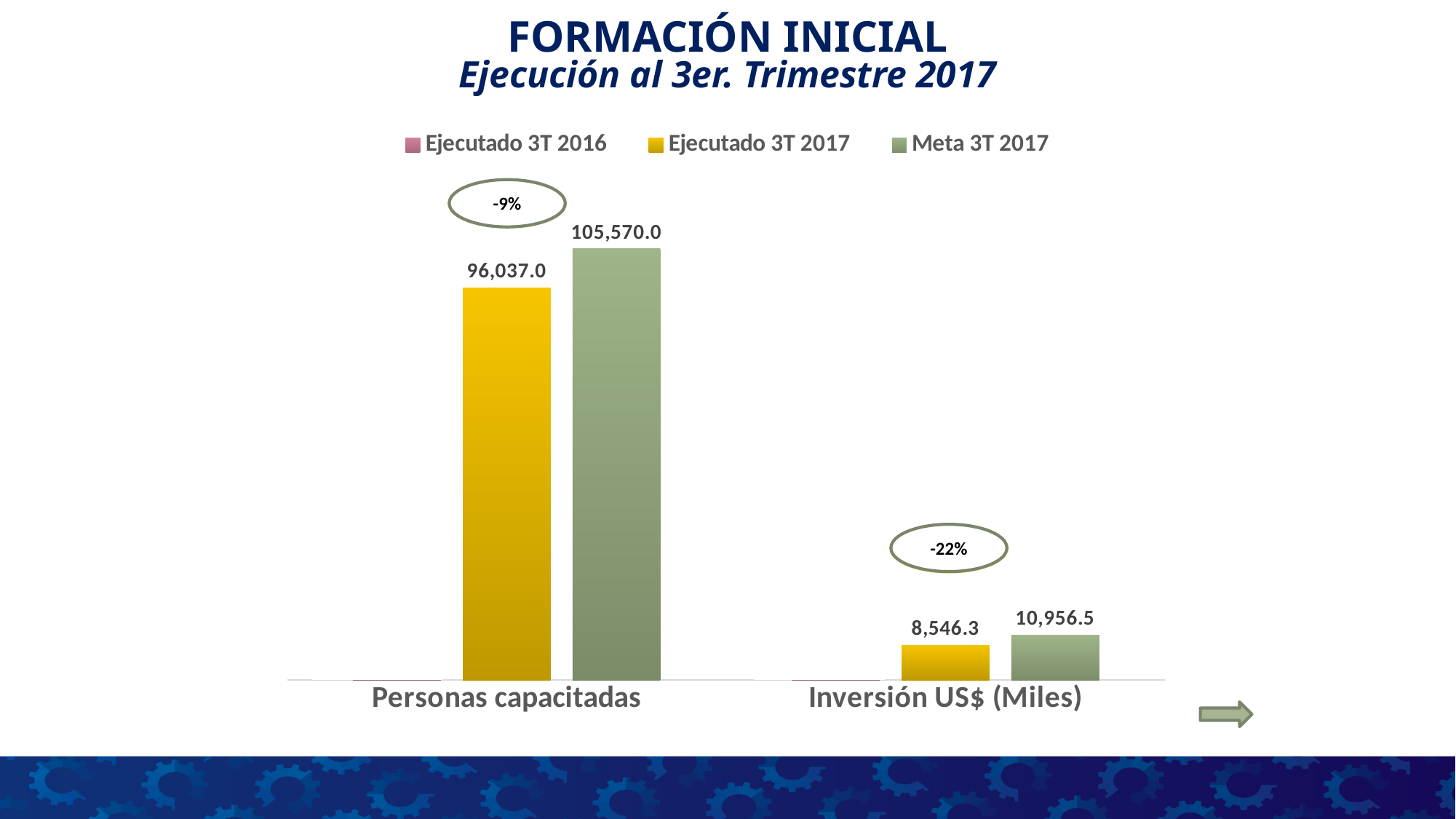
What kind of chart is shown on the slide? Bar chart Which category has the highest Meta 3T 2017 value? Personas capacitadas How many categories are shown on the x axis? 2 What is the difference between the Meta 3T 2017 and Ejecutado 3T 2017 values for Inversión US$ (Miles)? 2,410.2 How many series does the legend list? 3 For Inversión US$ (Miles), which is larger: Ejecutado 3T 2017 or Meta 3T 2017? Meta 3T 2017 What is the difference between the Meta 3T 2017 and Ejecutado 3T 2017 values for Personas capacitadas? 9,533.0 What is the Ejecutado 3T 2017 value for Personas capacitadas? 96,037.0 What is the Meta 3T 2017 value for Personas capacitadas? 105,570.0 Which category has the lowest Ejecutado 3T 2017 value? Inversión US$ (Miles) What is the Ejecutado 3T 2017 value for Inversión US$ (Miles)? 8,546.3 What is the Meta 3T 2017 value for Inversión US$ (Miles)? 10,956.5